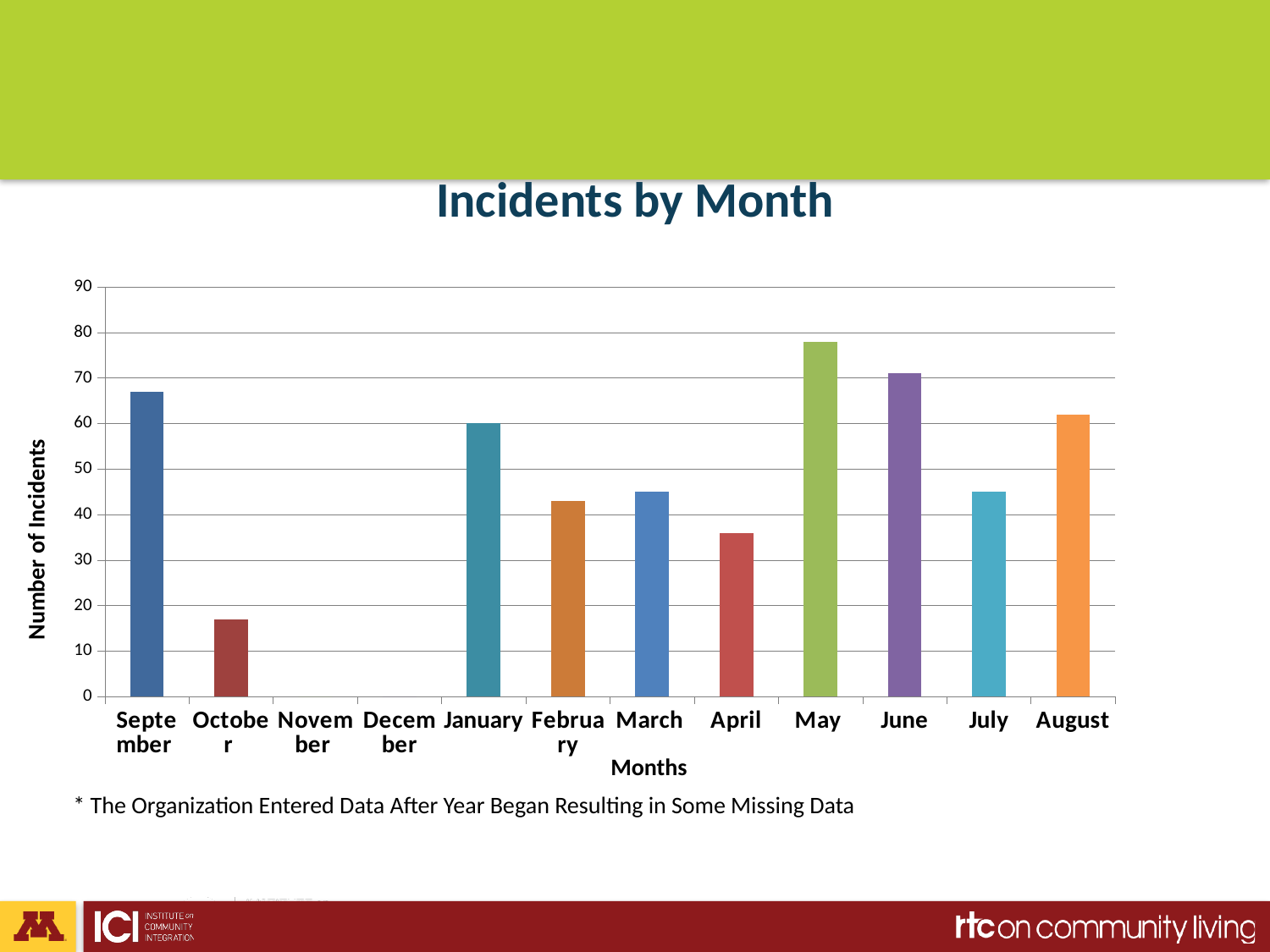
What is the number of incidents for January? 60 What is the title of the chart? Incidents by Month Which has more incidents, October or April? April Is the value for April greater or less than 40? less Which month has the highest number of incidents? May Is the value for October greater or less than 20? less How many months are shown on the x axis? 12 Is the value for September greater or less than 60? greater What type of chart is shown on the slide? bar chart Which has more incidents, May or June? May What is the label of the vertical axis? Number of Incidents